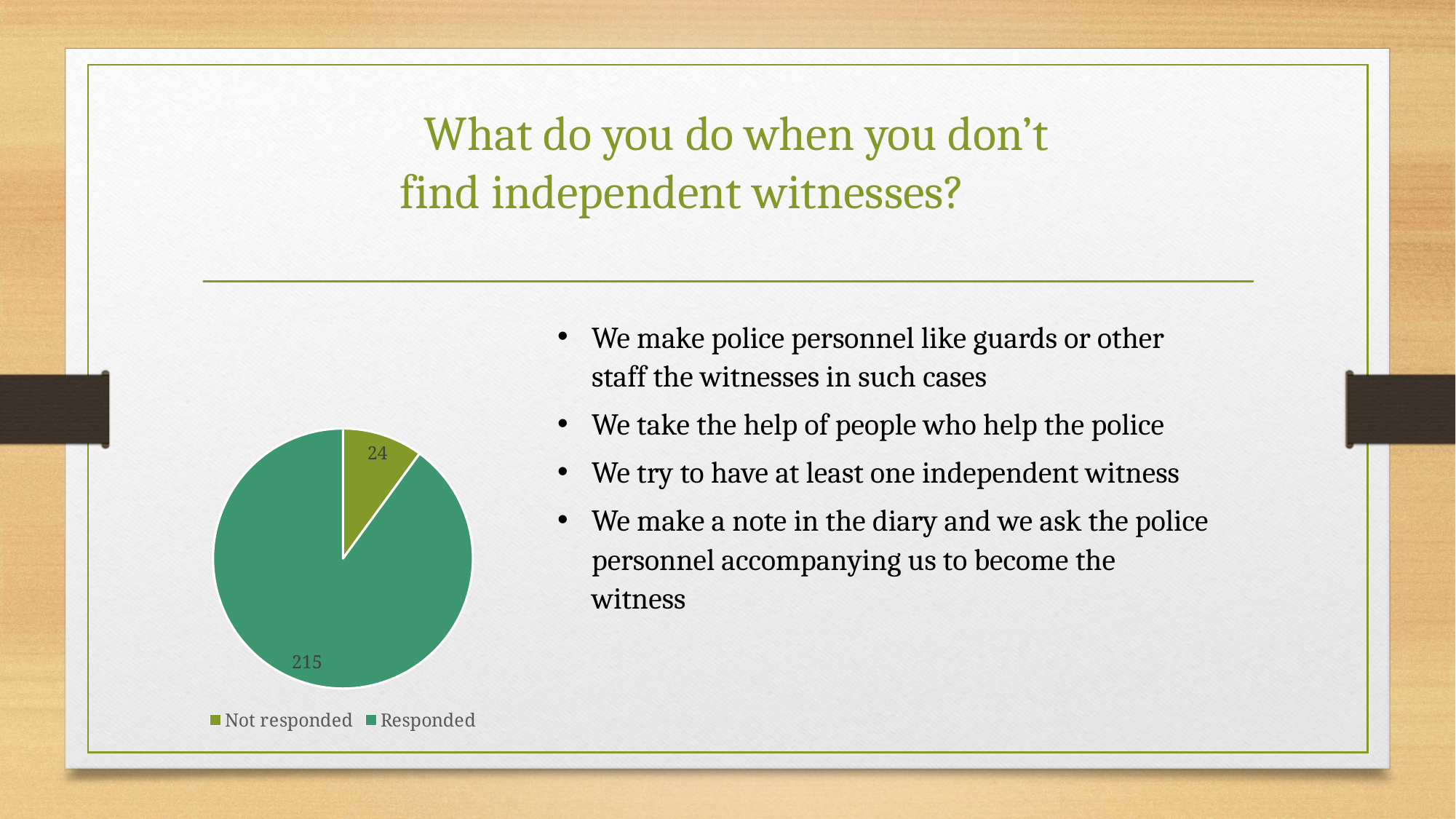
What is the difference between the Responded and Not responded values in the pie chart? 191 How many slices does the pie chart have? 2 How many entries does the legend of the pie chart list? 2 Which is larger in the pie chart, Responded or Not responded? Responded Which category has the smallest slice in the pie chart? Not responded What colour is the Not responded slice in the pie chart? Olive green Which category has the largest slice in the pie chart? Responded What is the total of all slices in the pie chart? 239 What is the value for the Not responded slice of the pie chart? 24 What is the value for the Responded slice of the pie chart? 215 What type of chart is shown on the slide? Pie chart